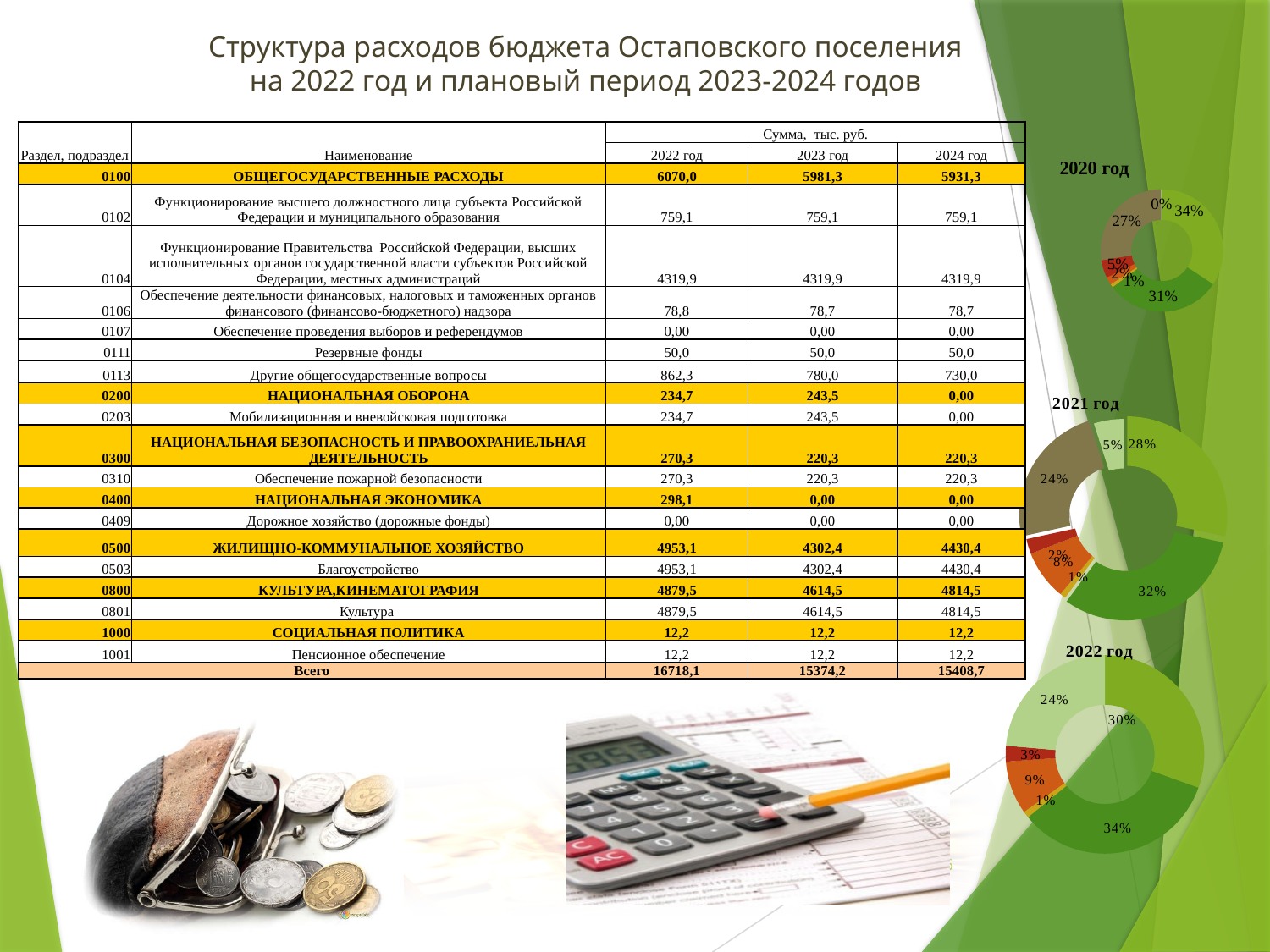
In the chart titled "2022 год", is the largest slice (34%) greater or less than 30%? greater What kind of chart is the chart titled "2022 год"? Doughnut (pie) chart In the chart titled "2021 год", what is the largest percentage label shown? 32% In the chart titled "2022 год", what is the difference between the slices labelled 34% and 24%? 10% In the chart titled "2020 год", what is the largest percentage label shown? 34% What are the titles of the three doughnut charts on the slide? 2020 год, 2021 год, 2022 год What kind of chart is the chart titled "2020 год"? Doughnut (pie) chart In the chart titled "2022 год", what is the largest percentage label shown? 34% In the chart titled "2020 год", what is the smallest percentage label shown? 0% How many doughnut charts are shown on the right side of the slide? 3 In the chart titled "2022 год", what is the smallest percentage label shown? 1% In the chart titled "2021 год", which is larger: the slice labelled 28% or the slice labelled 24%? 28%